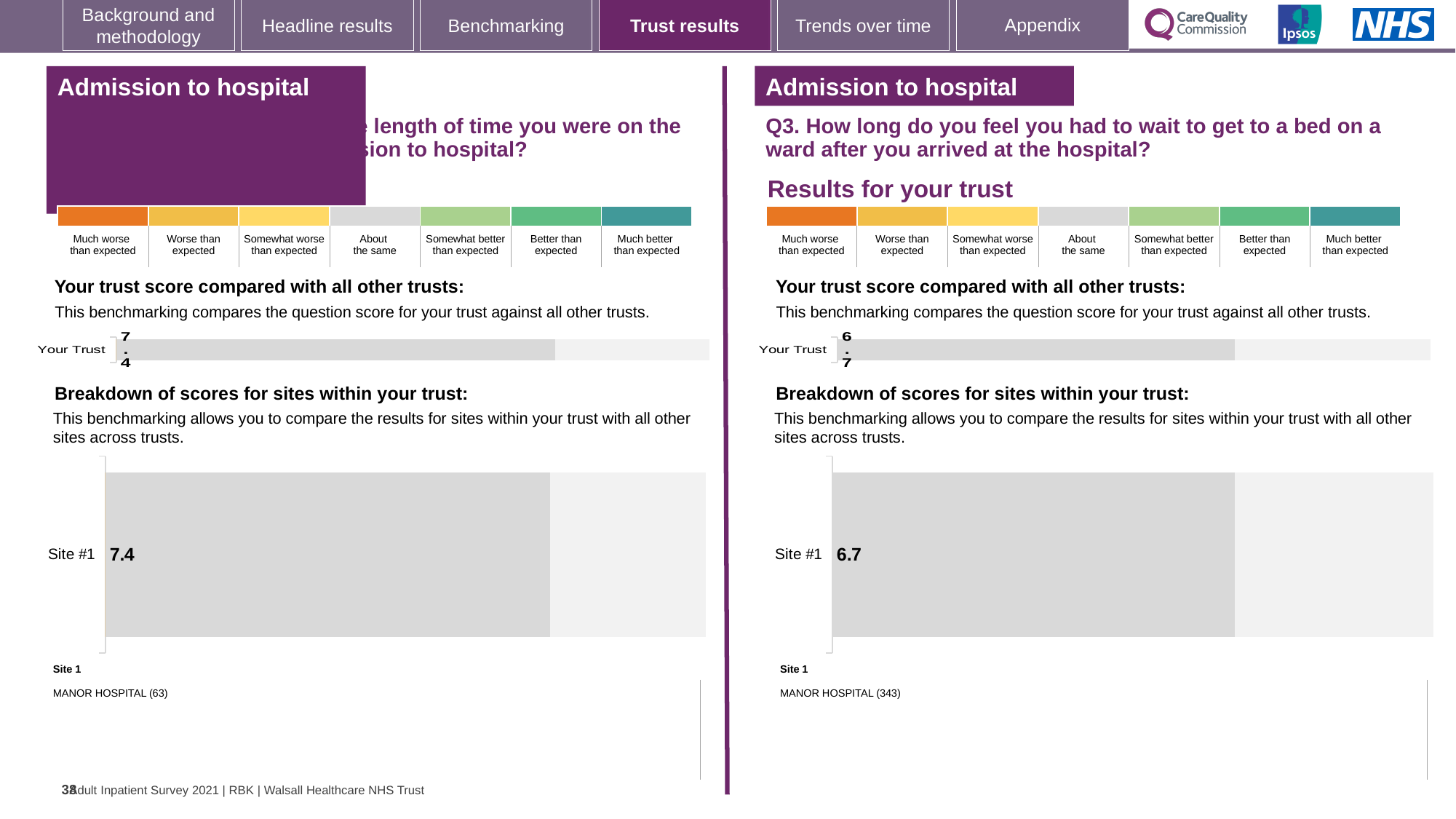
In the right panel (Q3) 'Breakdown of scores for sites within your trust' chart, what is the score for Site #1? 6.7 How many sites are shown in the right panel (Q3) 'Breakdown of scores for sites within your trust' chart? 1 In the left panel, which site name is listed as Site 1 below the breakdown chart? MANOR HOSPITAL (63) In the left panel's 'Your trust score compared with all other trusts' chart, what is the value shown for Your Trust? 7.4 How many sites are shown in the left panel's 'Breakdown of scores for sites within your trust' chart? 1 In the right panel (Q3), which site name is listed as Site 1 below the breakdown chart? MANOR HOSPITAL (343) What is the difference between the Site #1 score in the left panel and the Site #1 score in the right panel (Q3)? 0.7 What type of chart is used for the 'Your Trust' score in the right panel (Q3)? Bar chart In the left panel's 'Breakdown of scores for sites within your trust' chart, what is the score for Site #1? 7.4 Which is larger: the Your Trust score in the left panel or the Your Trust score in the right panel (Q3)? Left panel (7.4) In the right panel (Q3) 'Your trust score compared with all other trusts' chart, what is the value shown for Your Trust? 6.7 What type of chart is used for the Site #1 breakdown in the left panel? Bar chart